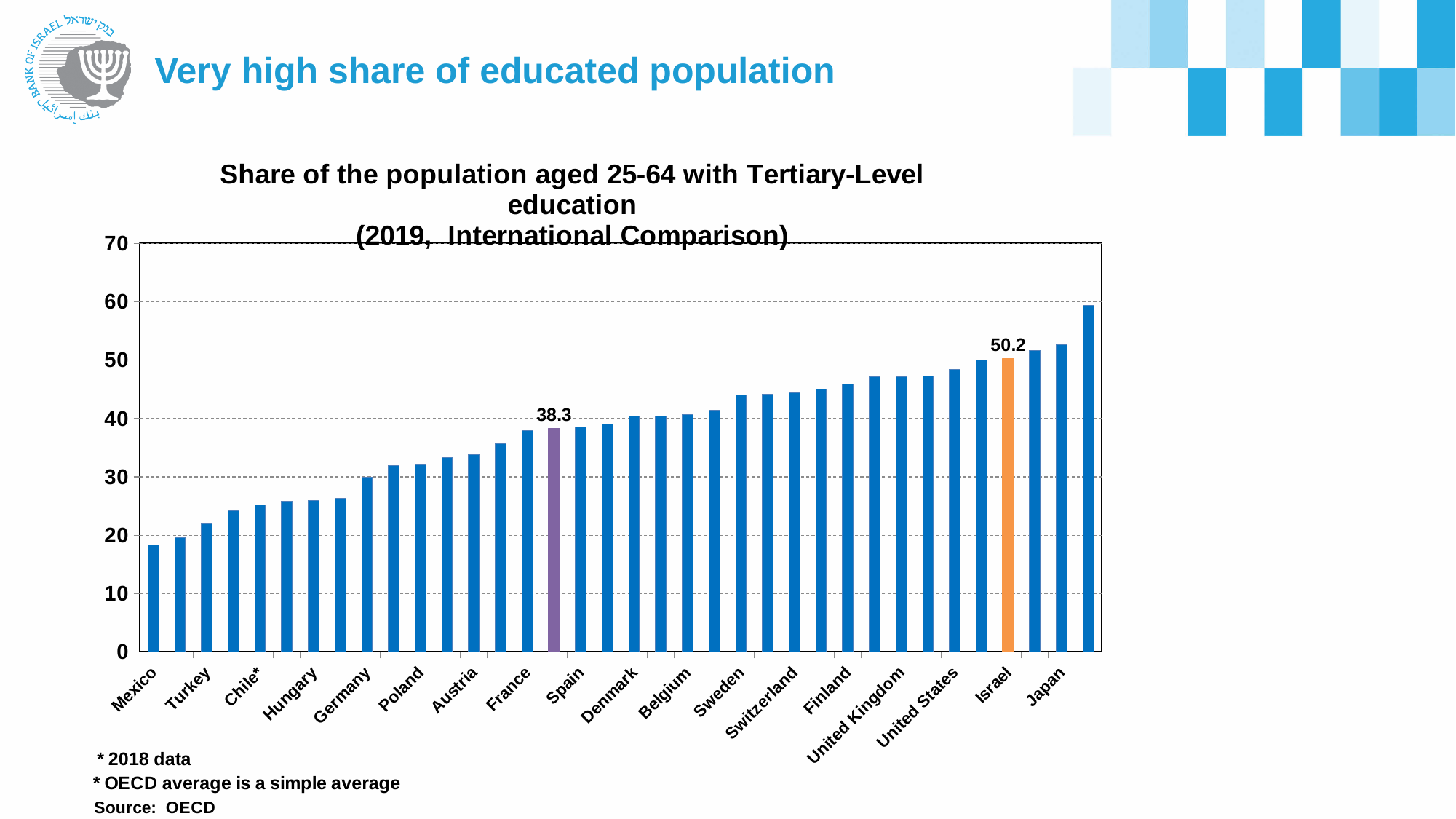
Do the values rise or fall from left to right along the x axis? rise Is the value for Sweden greater or less than 40? greater Which has a higher share, Germany or Sweden? Sweden Is the value for the United States greater or less than 50? less What value is printed on the purple bar? 38.3 What value is shown for Israel? 50.2 What is the difference between the value for Israel and the value printed on the purple bar? 11.9 Is the value for Japan greater or less than 50? greater Which labelled country has the lowest share? Mexico What kind of chart is shown on the slide? bar chart Which has a higher share, Israel or Japan? Japan